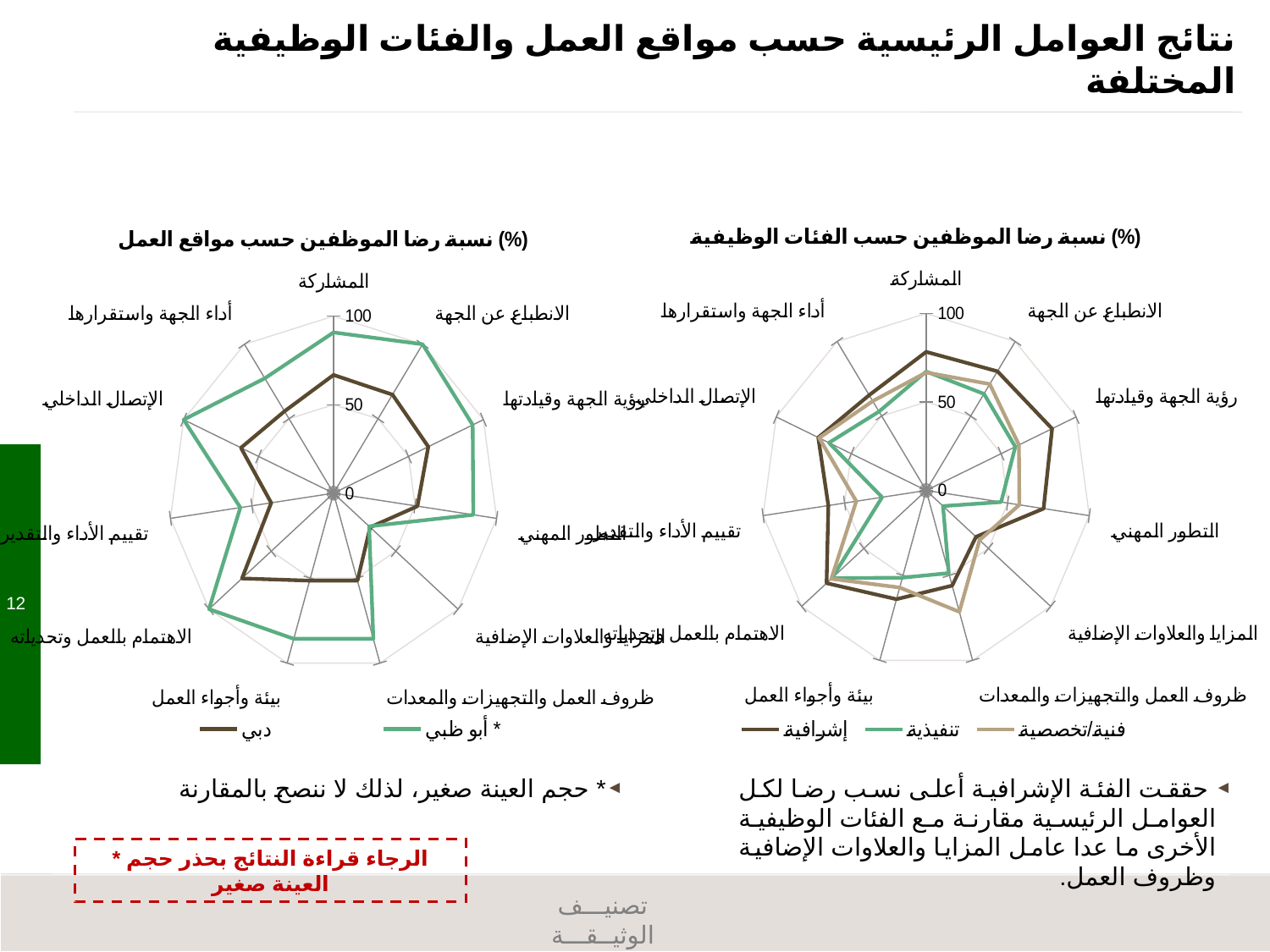
In the chart titled "(%) نسبة رضا الموظفين حسب الفئات الوظيفية", which series has the larger value for المزايا والعلاوات الإضافية, فنية/تخصصية or تنفيذية? فنية/تخصصية What kind of chart is the chart titled "(%) نسبة رضا الموظفين حسب الفئات الوظيفية"? Radar chart How many series does the legend of the chart titled "(%) نسبة رضا الموظفين حسب مواقع العمل" list? 2 In the chart titled "(%) نسبة رضا الموظفين حسب الفئات الوظيفية", is the value of إشرافية for المشاركة greater or less than 50? greater In the chart titled "(%) نسبة رضا الموظفين حسب مواقع العمل", which series has the larger value for الإتصال الداخلي, دبي or أبو ظبي? أبو ظبي In the chart titled "(%) نسبة رضا الموظفين حسب مواقع العمل", which series has the larger value for المشاركة, دبي or أبو ظبي? أبو ظبي In the chart titled "(%) نسبة رضا الموظفين حسب مواقع العمل", is the value of أبو ظبي for المشاركة greater or less than 50? greater What are the legend entries of the chart titled "(%) نسبة رضا الموظفين حسب الفئات الوظيفية"? إشرافية, تنفيذية, فنية/تخصصية In the chart titled "(%) نسبة رضا الموظفين حسب مواقع العمل", is the value of أبو ظبي for الإتصال الداخلي greater or less than 50? greater How many series does the legend of the chart titled "(%) نسبة رضا الموظفين حسب الفئات الوظيفية" list? 3 What are the legend entries of the chart titled "(%) نسبة رضا الموظفين حسب مواقع العمل"? دبي, أبو ظبي *